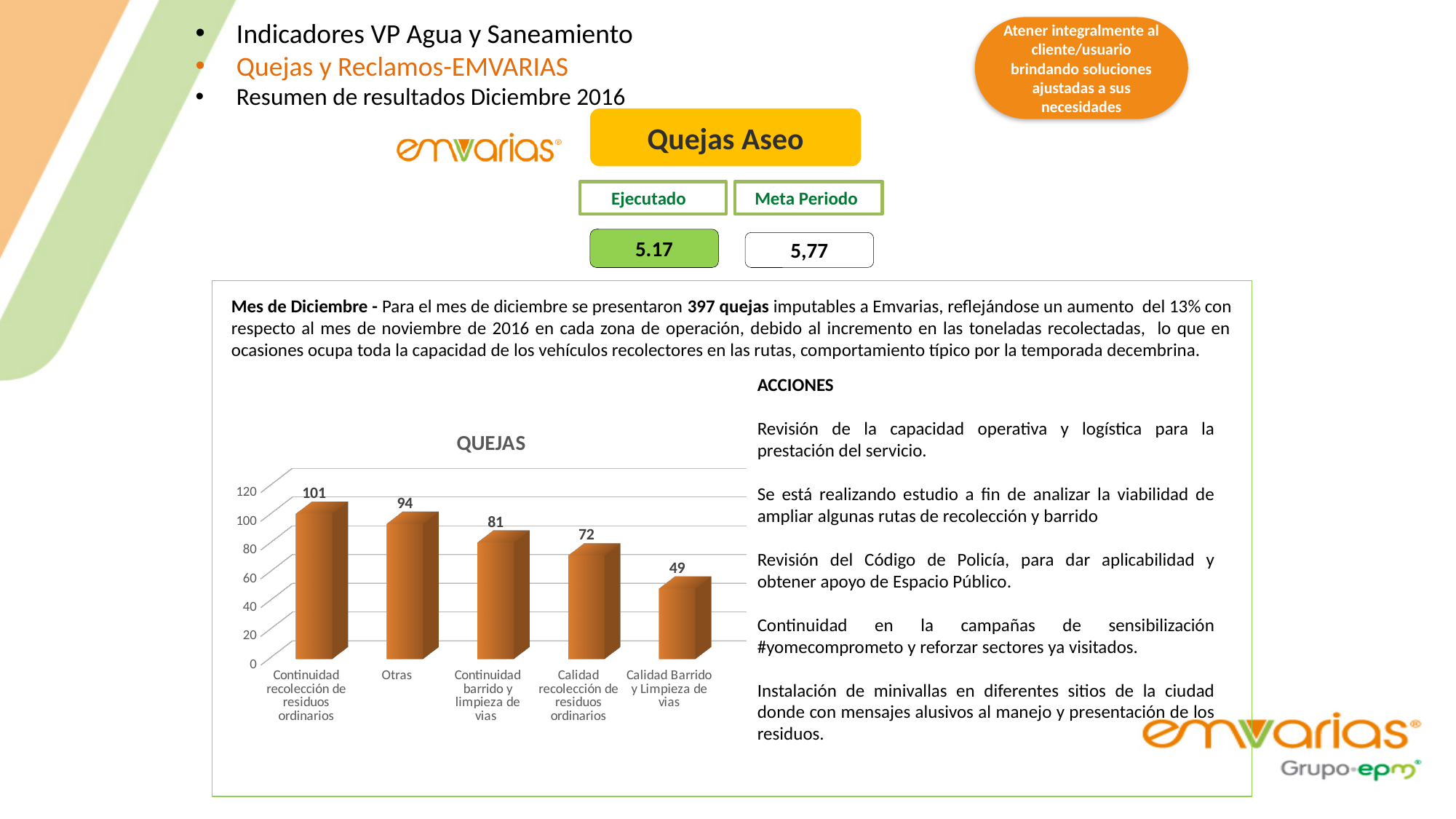
How many categories are shown in the QUEJAS chart? 5 Which is larger in the QUEJAS chart: 'Continuidad barrido y limpieza de vias' or 'Calidad recolección de residuos ordinarios'? Continuidad barrido y limpieza de vias Do the values in the QUEJAS chart rise or fall from left to right? Fall What is the difference between the values for 'Continuidad recolección de residuos ordinarios' and 'Calidad Barrido y Limpieza de vias' in the QUEJAS chart? 52 What is the value for 'Otras' in the QUEJAS chart? 94 Which category has the highest value in the QUEJAS chart? Continuidad recolección de residuos ordinarios What is the value for 'Calidad Barrido y Limpieza de vias' in the QUEJAS chart? 49 Which category has the lowest value in the QUEJAS chart? Calidad Barrido y Limpieza de vias What is the value for 'Continuidad recolección de residuos ordinarios' in the QUEJAS chart? 101 What kind of chart is the QUEJAS chart? Bar chart What is the value for 'Calidad recolección de residuos ordinarios' in the QUEJAS chart? 72 What is the title of the chart on the slide? QUEJAS